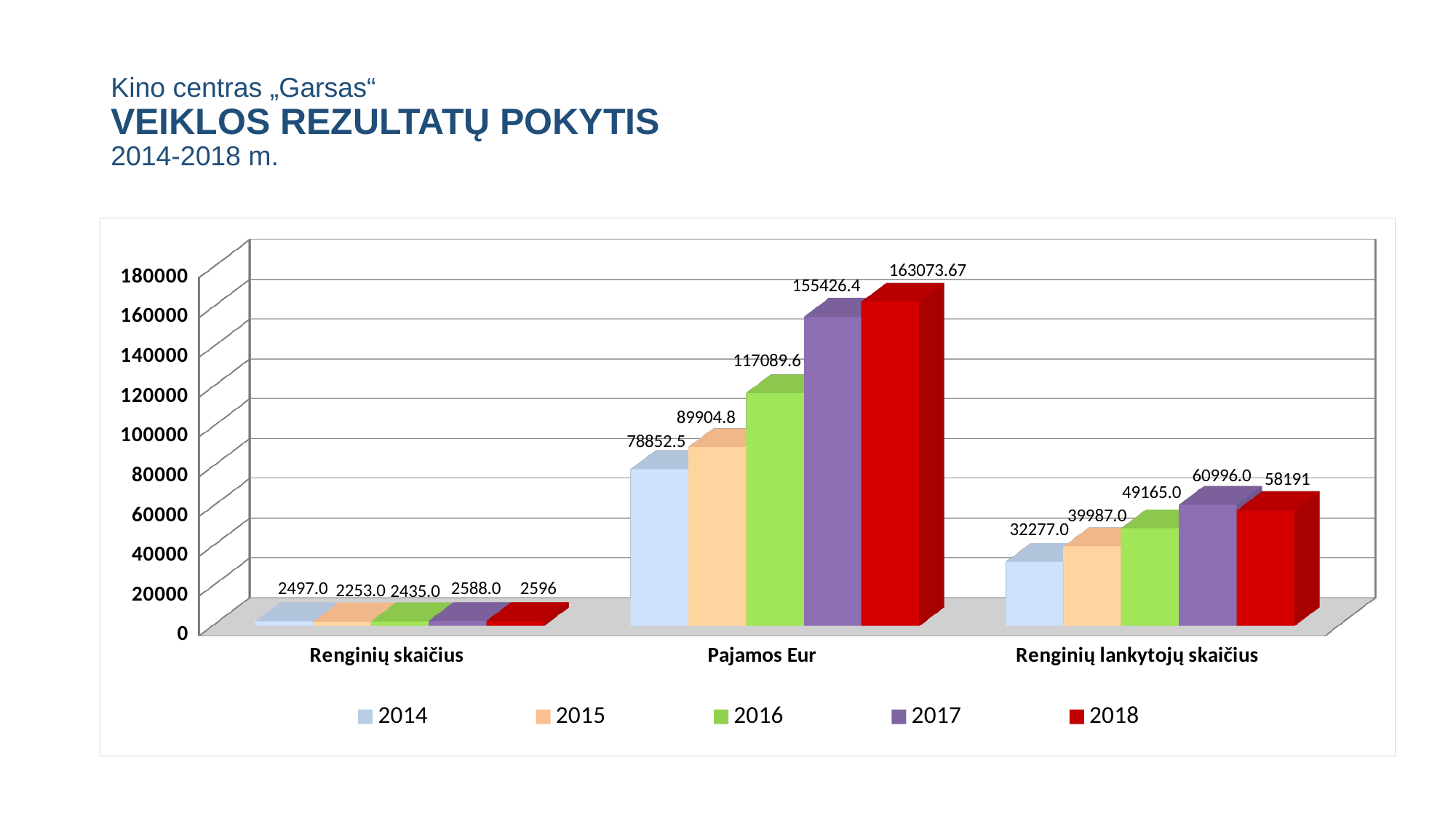
Which is larger in the Renginių lankytojų skaičius category, the value for 2017 or the value for 2018? 2017 Do the Pajamos Eur values rise or fall from 2014 to 2018? rise What is the difference between the 2018 and 2017 values in the Pajamos Eur category? 7647.27 What is the value for 2017 in the Renginių lankytojų skaičius category? 60996.0 What is the value for 2015 in the Renginių skaičius category? 2253.0 What kind of chart is shown on the slide? bar chart What is the value for 2018 in the Pajamos Eur category? 163073.67 Which year is shown in red in the legend? 2018 How many series does the legend list? 5 Which year has the highest value in the Renginių lankytojų skaičius category? 2017 Which year has the lowest value in the Pajamos Eur category? 2014 How many categories are shown on the x axis? 3